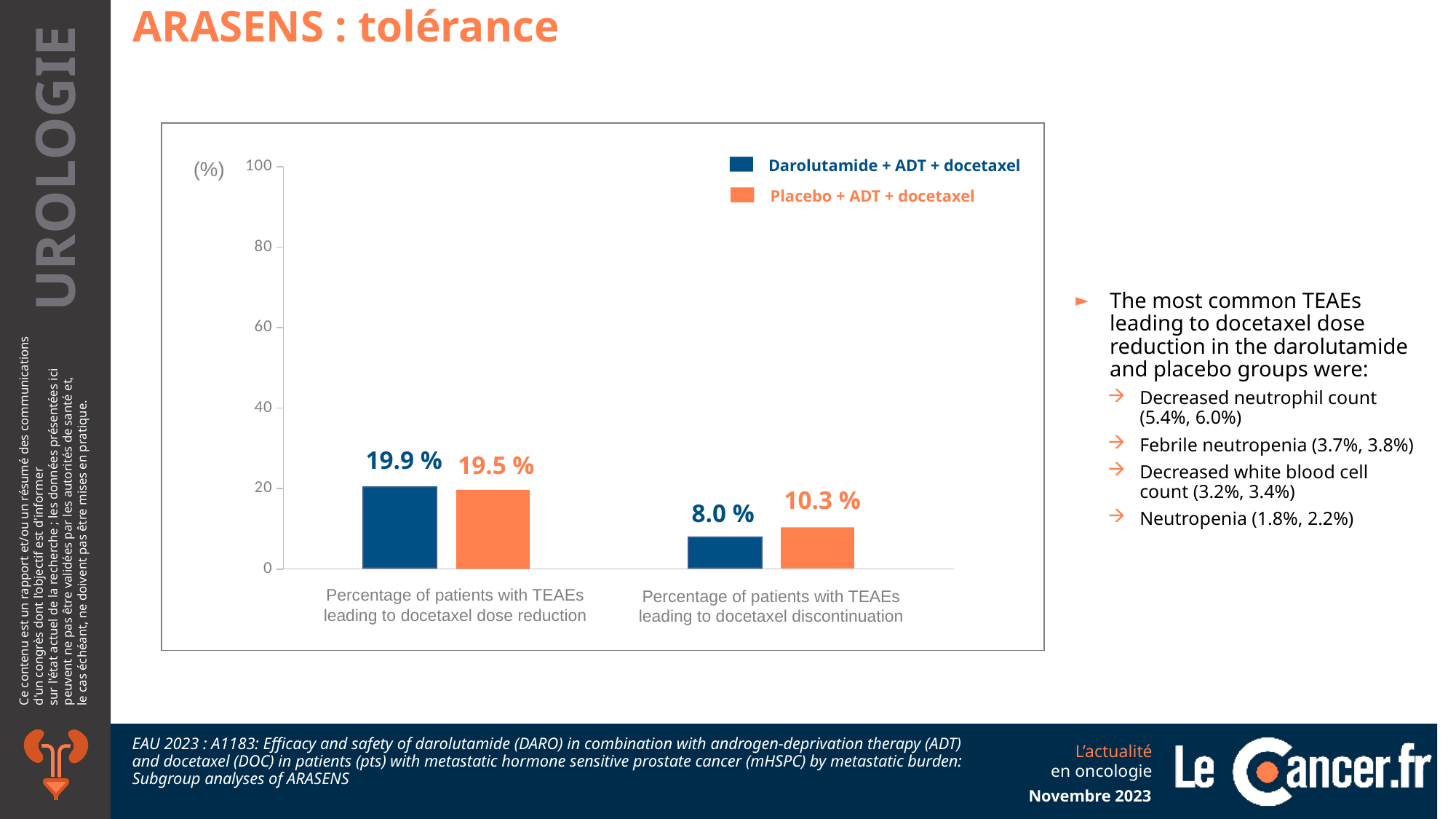
What is the value for Placebo + ADT + docetaxel for percentage of patients with TEAEs leading to docetaxel discontinuation? 10.3 % Which series has the higher value for percentage of patients with TEAEs leading to docetaxel discontinuation? Placebo + ADT + docetaxel What kind of chart is shown on the slide? Bar chart Is the value for Darolutamide + ADT + docetaxel for TEAEs leading to docetaxel dose reduction greater or less than 40? less What is the difference between the Darolutamide + ADT + docetaxel and Placebo + ADT + docetaxel values for TEAEs leading to docetaxel dose reduction? 0.4 % What is the value for Darolutamide + ADT + docetaxel for percentage of patients with TEAEs leading to docetaxel dose reduction? 19.9 % What is the difference between the Placebo + ADT + docetaxel and Darolutamide + ADT + docetaxel values for TEAEs leading to docetaxel discontinuation? 2.3 % How many categories are shown on the x axis? 2 What is the value for Placebo + ADT + docetaxel for percentage of patients with TEAEs leading to docetaxel dose reduction? 19.5 % How many series does the legend list? 2 Which bar has the lowest value on the chart? Darolutamide + ADT + docetaxel, TEAEs leading to docetaxel discontinuation What is the value for Darolutamide + ADT + docetaxel for percentage of patients with TEAEs leading to docetaxel discontinuation? 8.0 %